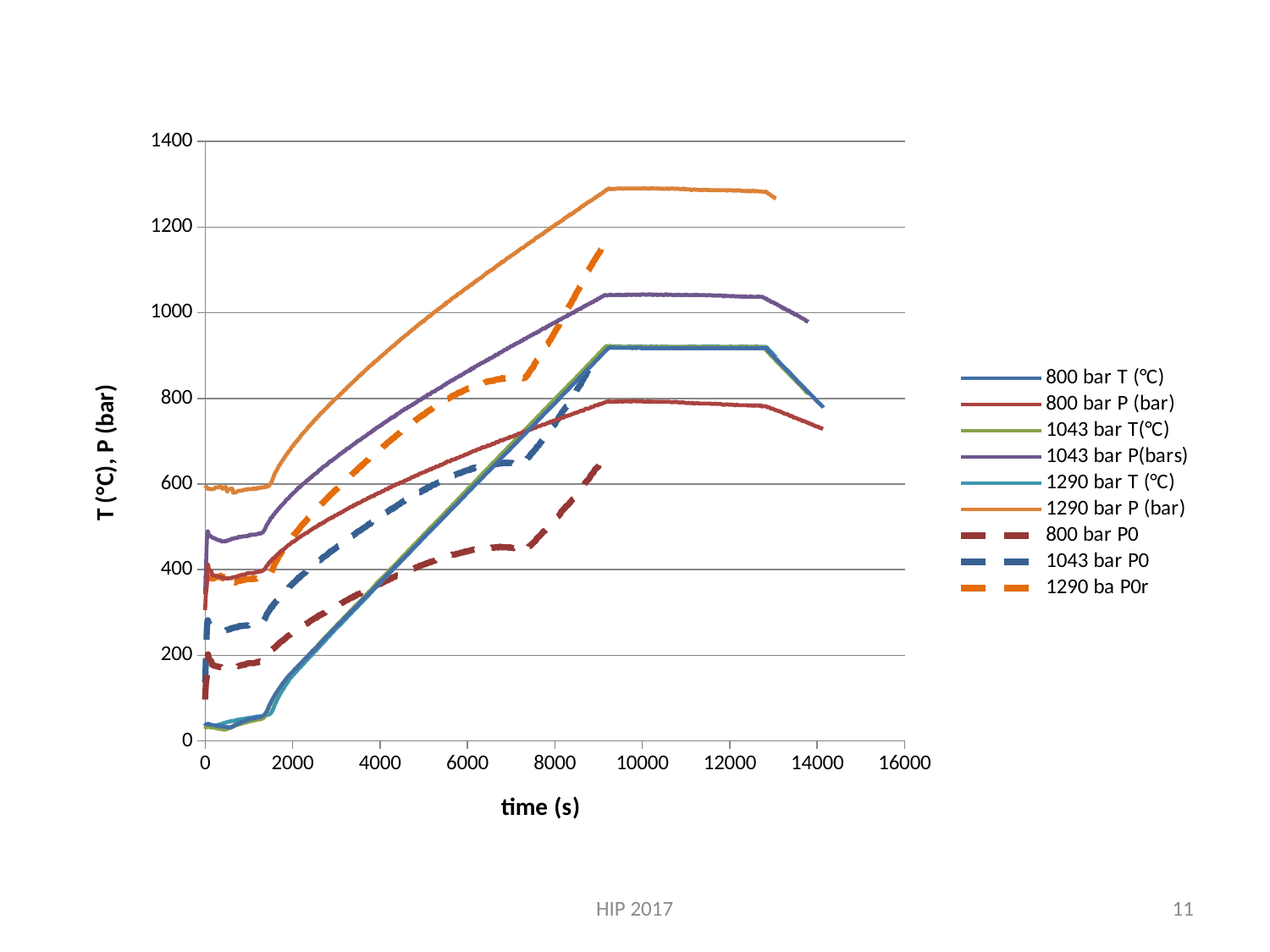
Is the value of the 800 bar P (bar) series at 10000 s greater or less than 600? greater Does the 1290 bar P (bar) series rise or fall between 2000 s and 8000 s? rise What is the title of the y axis? T (°C), P (bar) Is the value of the 1043 bar P(bars) series at 10000 s greater or less than 1200? less Is the value of the 800 bar P0 series at 6000 s greater or less than 600? less What is the title of the x axis? time (s) How many series does the legend list? 9 At 10000 s, which series has the higher value: 1290 bar P (bar) or 800 bar P (bar)? 1290 bar P (bar) Which series reaches the highest value on the chart? 1290 bar P (bar) What kind of chart is shown on the slide? line chart Does the 800 bar T (°C) series rise or fall between 2000 s and 9000 s? rise